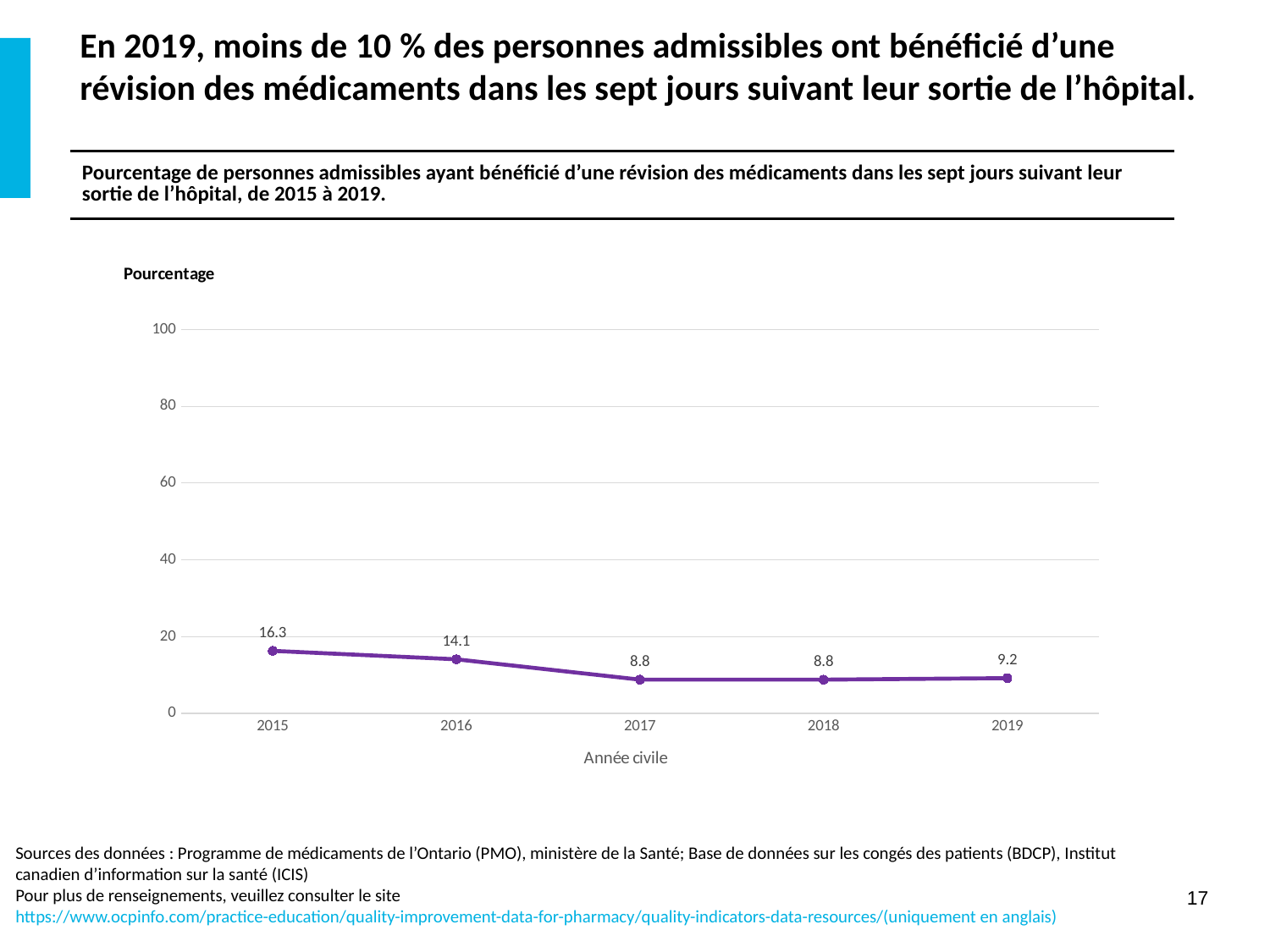
Which is larger, the value for 2016 or the value for 2017? 2016 What is the value for 2019? 9.2 Do the values generally rise or fall from 2015 to 2017? fall What is the label of the x axis? Année civile What is the difference between the values for 2019 and 2018? 0.4 What is the value for 2015? 16.3 Which year has the highest value? 2015 What is the difference between the values for 2015 and 2016? 2.2 What kind of chart is shown on the slide? line chart How many years are plotted on the chart? 5 What is the value for 2016? 14.1 Is the value for 2015 greater or less than 20? less